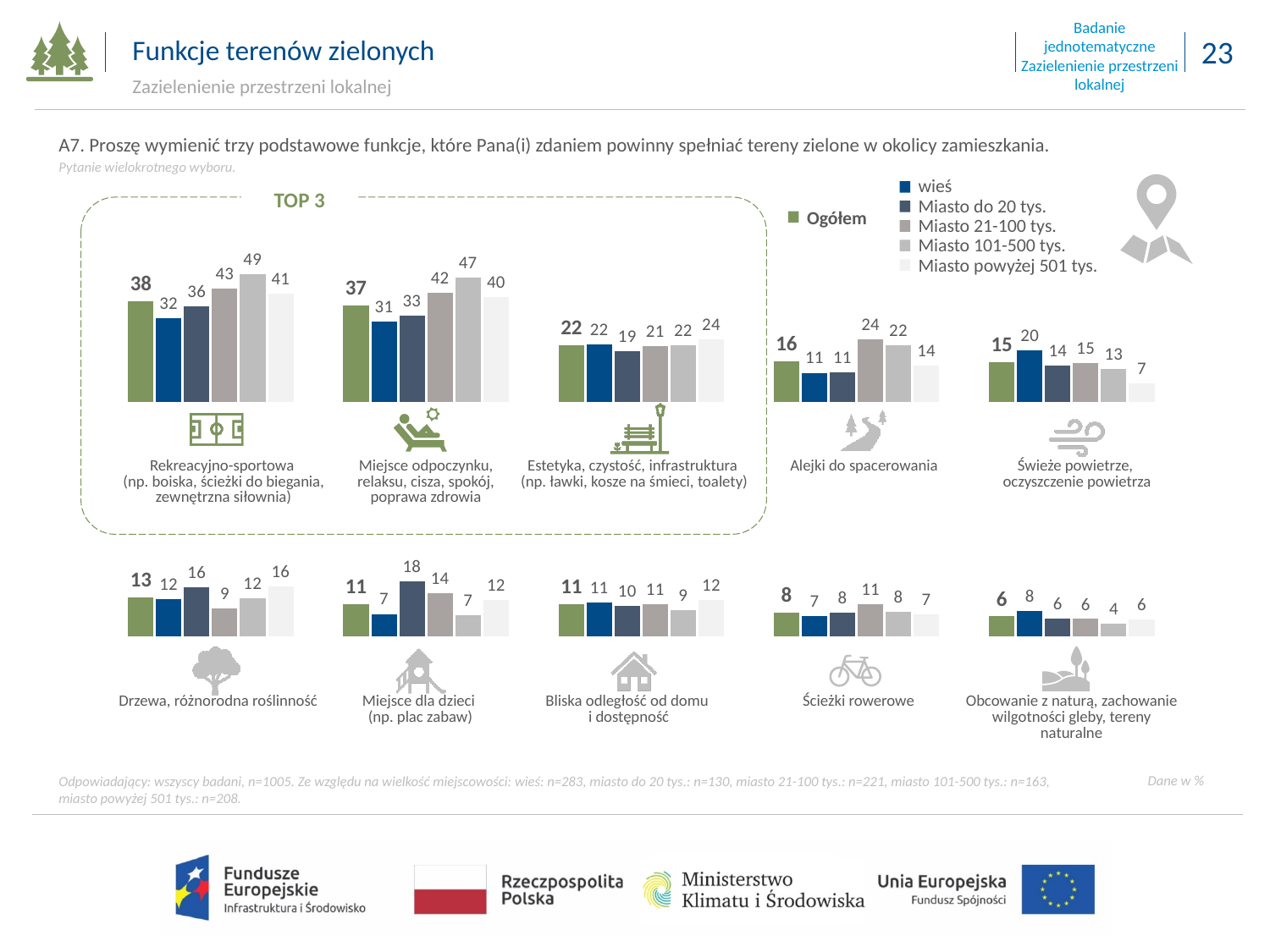
In the 'Obcowanie z naturą, zachowanie wilgotności gleby, tereny naturalne' chart, what is the value for Miasto 101-500 tys.? 4 In the 'Miejsce dla dzieci (np. plac zabaw)' chart, which group has the highest value? Miasto do 20 tys. In the 'Miejsce odpoczynku, relaksu, cisza, spokój, poprawa zdrowia' chart, what is the value for wieś? 31 How many series does the legend list for the charts on this slide? 6 In the 'Rekreacyjno-sportowa' chart, what is the value for Ogółem? 38 In the 'Rekreacyjno-sportowa' chart, which group has the highest value? Miasto 101-500 tys. In the 'Miejsce odpoczynku, relaksu, cisza, spokój, poprawa zdrowia' chart, what is the difference between the Miasto 101-500 tys. value and the wieś value? 16 In the 'Drzewa, różnorodna roślinność' chart, which is larger: the value for Miasto do 20 tys. or the value for Miasto 21-100 tys.? Miasto do 20 tys. What type of chart is used for 'Estetyka, czystość, infrastruktura'? Bar chart In the 'Świeże powietrze, oczyszczenie powietrza' chart, which group has the lowest value? Miasto powyżej 501 tys. In the 'Ścieżki rowerowe' chart, what is the value for Ogółem? 8 In the 'Alejki do spacerowania' chart, what is the value for Miasto 21-100 tys.? 24